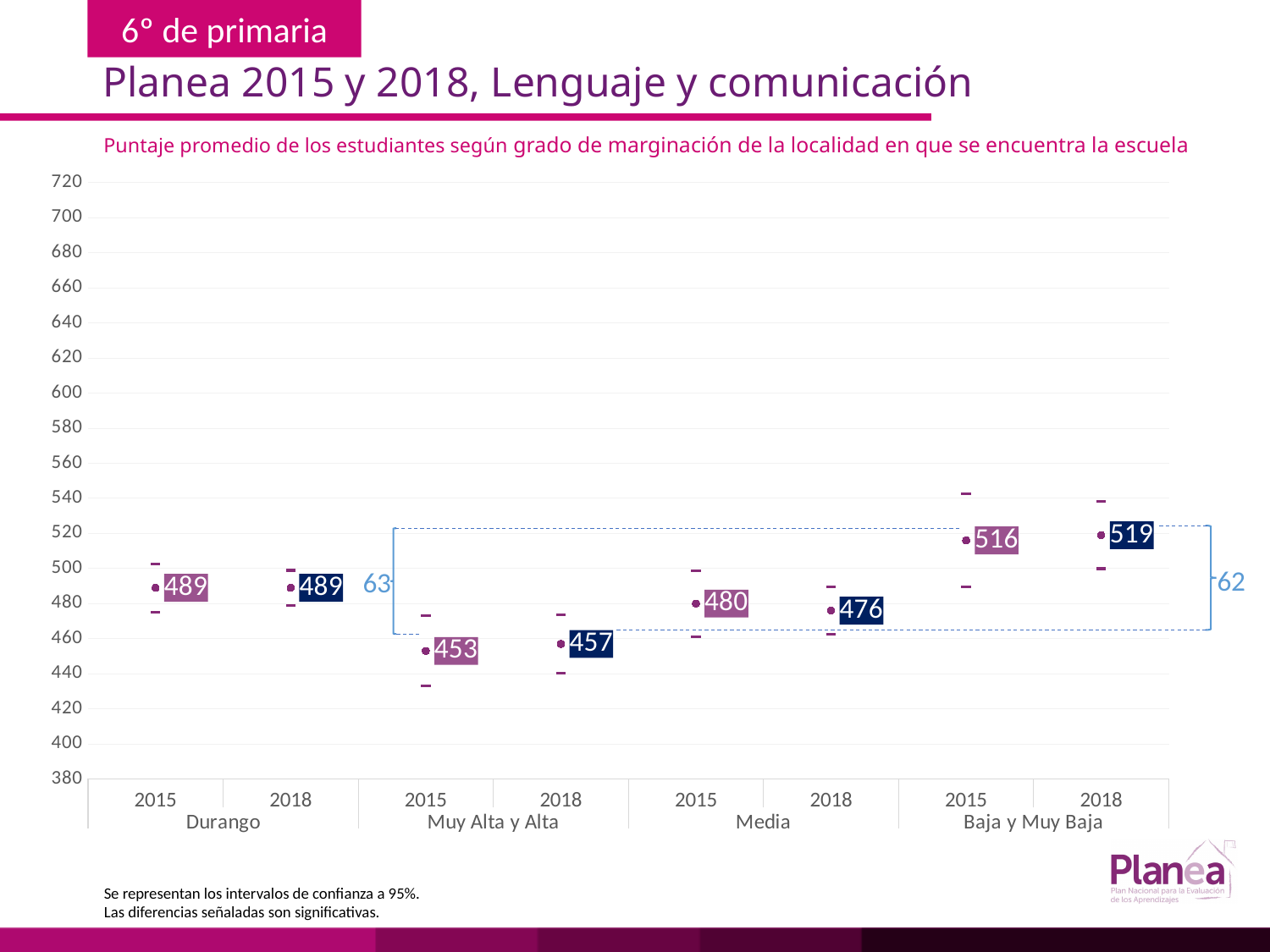
What is the average score for the Baja y Muy Baja group in 2018? 519 Did the Durango average score change between 2015 and 2018? No, it stayed at 489 Which group and year has the highest average score? Baja y Muy Baja, 2018 What is the average score for the Muy Alta y Alta marginación group in 2018? 457 How many marginación groups (including Durango) are shown on the x axis? 4 Which is larger, the Media score in 2015 or in 2018? 2015 Which group and year has the lowest average score? Muy Alta y Alta, 2015 What is the average score for Durango in 2015? 489 What is the difference between the 2018 scores of the Baja y Muy Baja group and the Muy Alta y Alta group? 62 What is the average score for the Media group in 2015? 480 What is the difference between the 2015 scores of the Baja y Muy Baja group and the Muy Alta y Alta group? 63 What is the subtitle of the chart? Puntaje promedio de los estudiantes según grado de marginación de la localidad en que se encuentra la escuela